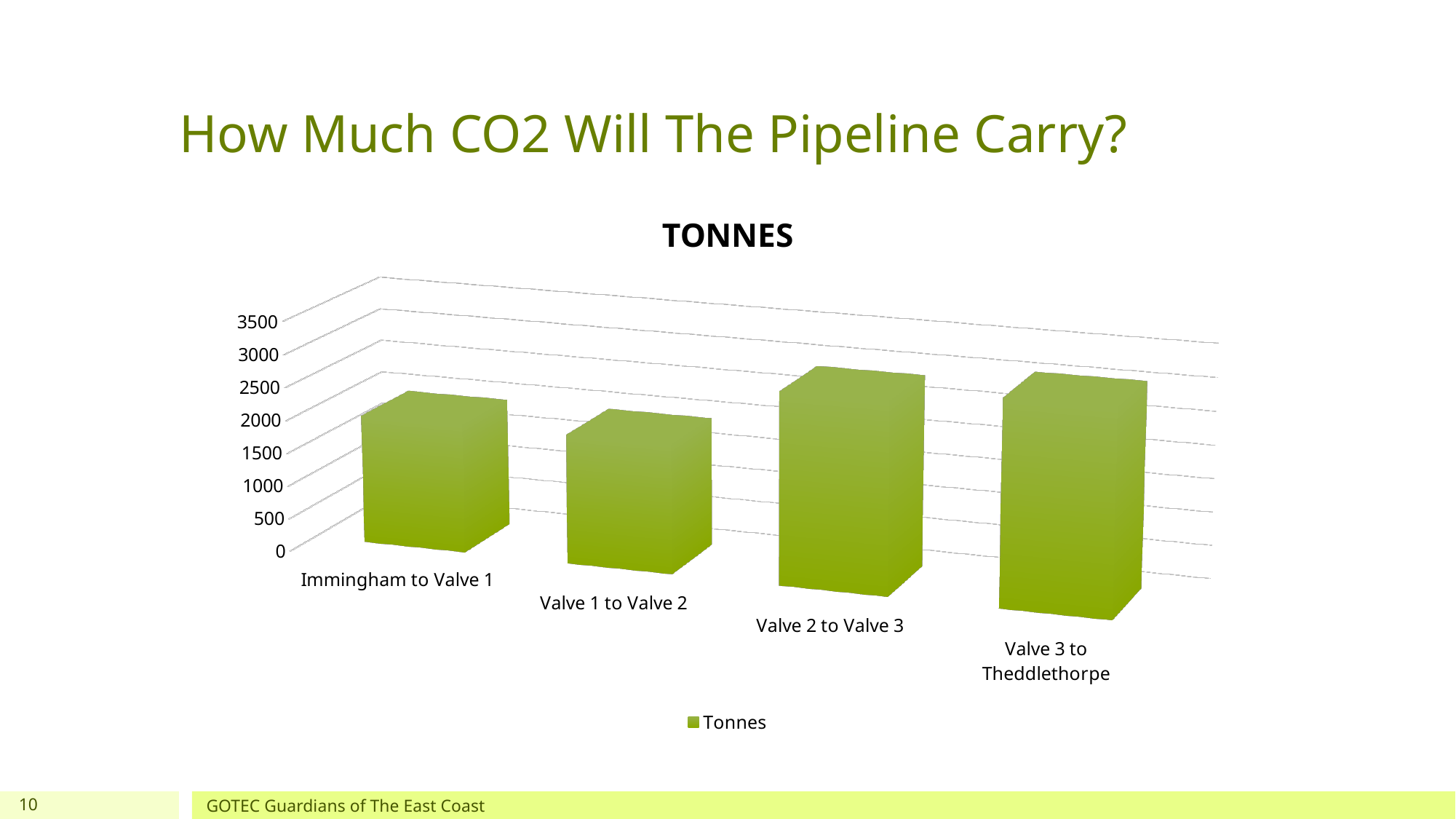
What is the title of the chart? TONNES Is the value for Immingham to Valve 1 greater or less than 1000? greater Which is larger, the value for Valve 2 to Valve 3 or the value for Immingham to Valve 1? Valve 2 to Valve 3 How many pipeline sections (categories) are plotted in the chart? 4 What series name appears in the chart legend? Tonnes What kind of chart is shown on the slide? Bar chart Is the value for Valve 3 to Theddlethorpe greater or less than 1500? greater Which is larger, the value for Valve 3 to Theddlethorpe or the value for Valve 1 to Valve 2? Valve 3 to Theddlethorpe How many series does the chart legend list? 1 Is the value for Valve 2 to Valve 3 greater or less than 2000? greater